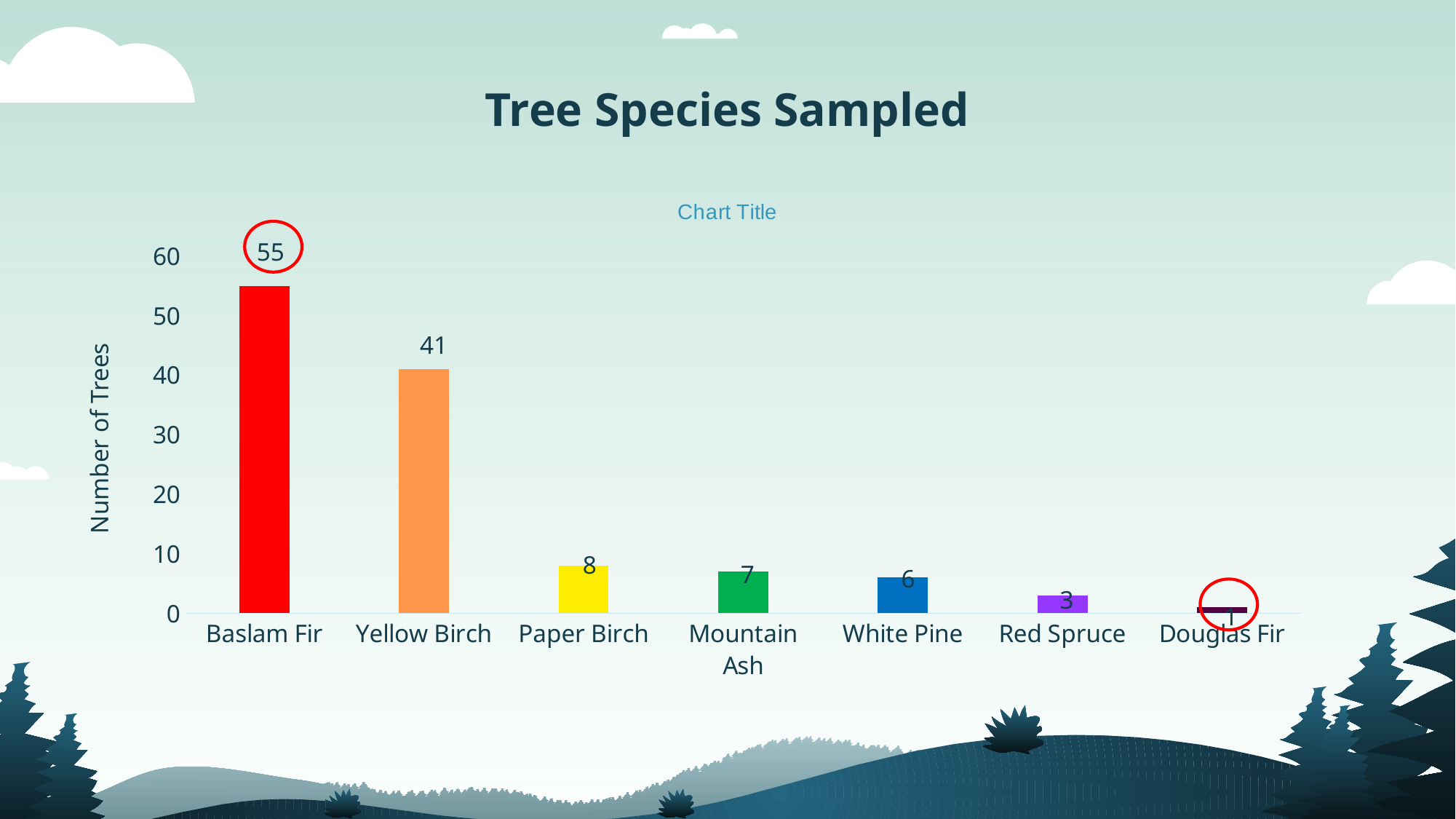
Which tree species has the lowest number of trees? Douglas Fir How many trees were sampled for Baslam Fir? 55 What is the value for Paper Birch? 8 What is the difference between the values for Baslam Fir and Yellow Birch? 14 What is the value for Red Spruce? 3 What is the label of the vertical axis? Number of Trees Which is larger, the value for Mountain Ash or the value for White Pine? Mountain Ash Is the value for Douglas Fir greater or less than 10? less Which tree species has the highest number of trees? Baslam Fir What kind of chart is shown on the slide? bar chart What is the value for Yellow Birch? 41 How many tree species are shown on the x axis? 7